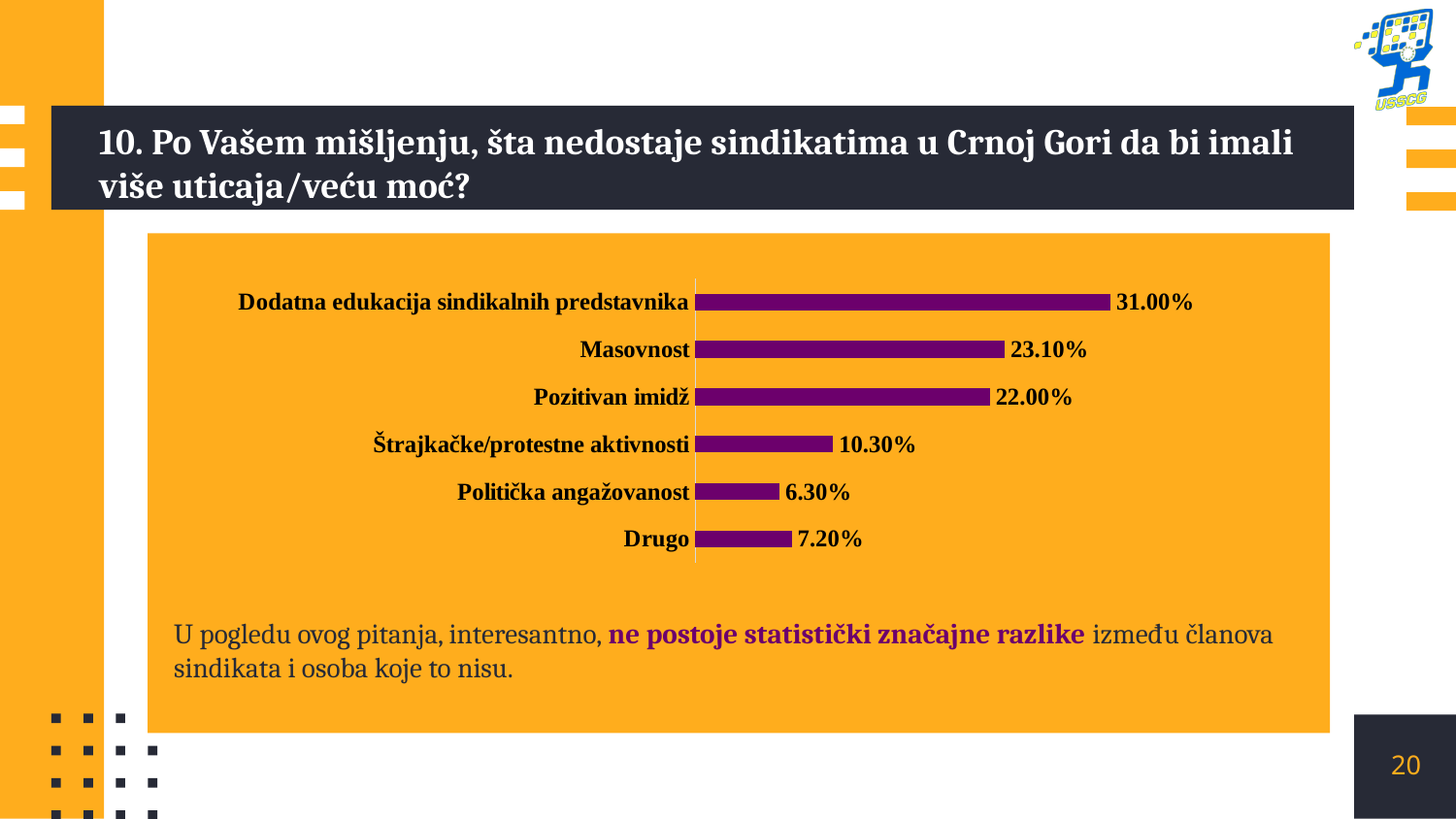
What is the difference between the values for Dodatna edukacija sindikalnih predstavnika and Masovnost? 7.90% What is the value for Masovnost? 23.10% What is the value for Dodatna edukacija sindikalnih predstavnika? 31.00% What is the difference between the values for Drugo and Politička angažovanost? 0.90% Which category has the highest value? Dodatna edukacija sindikalnih predstavnika What colour are the bars in the chart? Purple What is the value for Drugo? 7.20% What is the value for Štrajkačke/protestne aktivnosti? 10.30% Which category has the lowest value? Politička angažovanost Which is larger, the value for Pozitivan imidž or the value for Štrajkačke/protestne aktivnosti? Pozitivan imidž How many categories are shown in the chart? 6 What kind of chart is shown on the slide? Bar chart